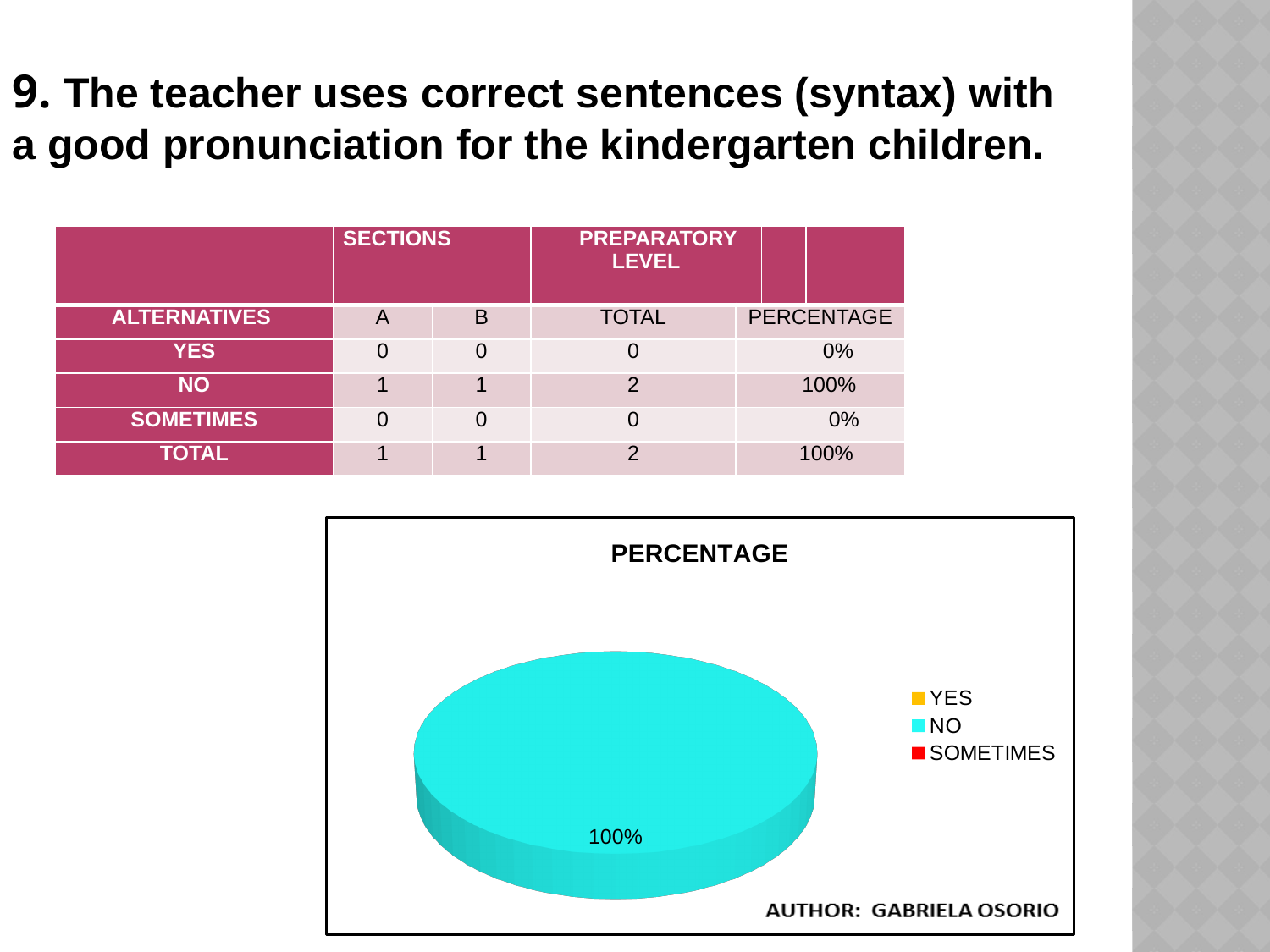
What kind of chart is shown on the slide? pie chart Which category makes up the entire pie in the chart? NO Which colour represents the NO category in the chart legend? cyan What is the title of the chart? PERCENTAGE How many visible slices does the pie chart have? 1 Is the value for NO in the chart greater or less than 50%? greater How many entries does the chart legend list? 3 Which is larger in the chart, the share for NO or the share for YES? NO What share of the pie does the NO category have? 100% What percentage is shown on the pie slice in the chart? 100%